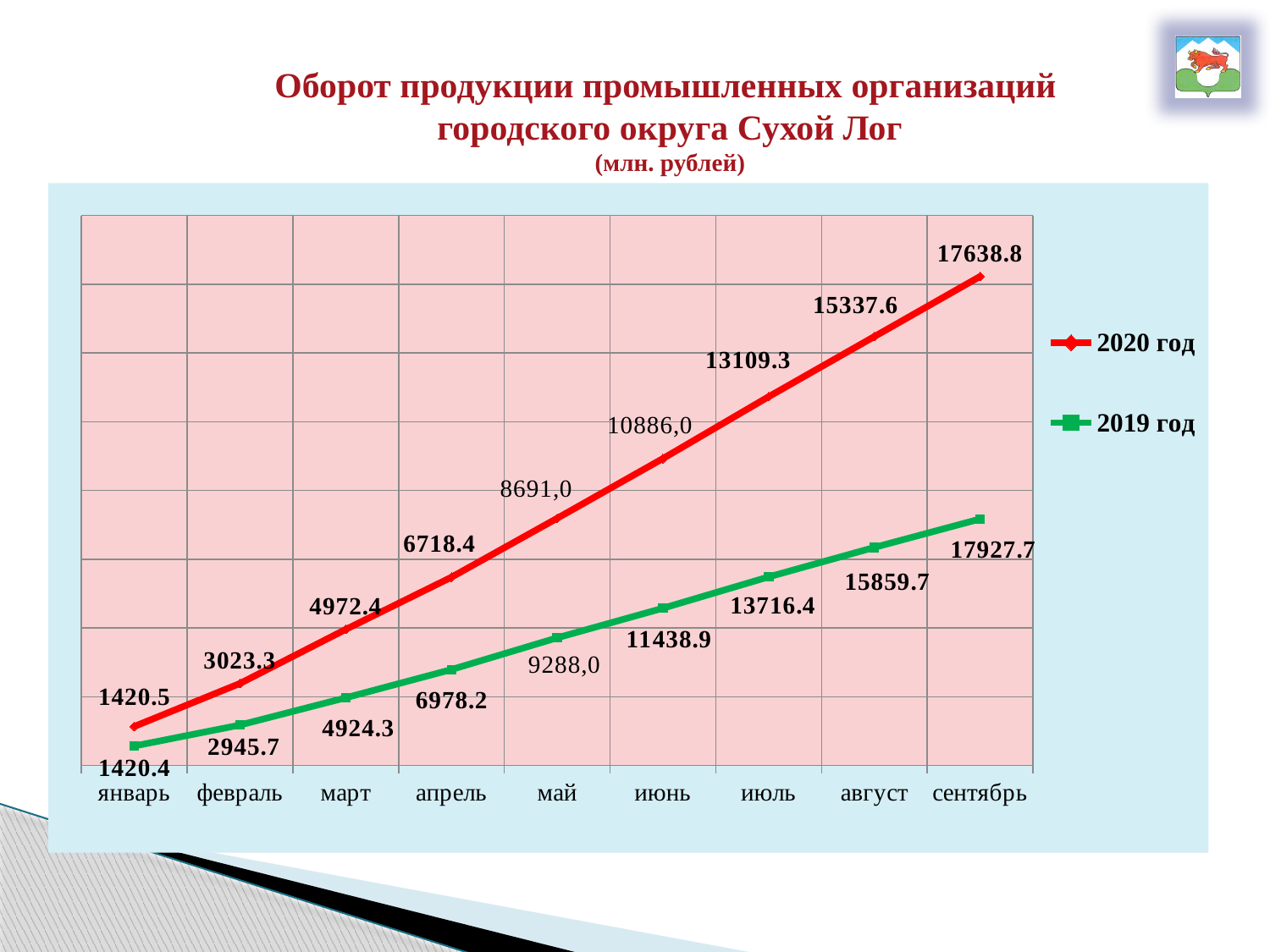
What unit is given in the chart title? млн. рублей How many series does the legend list? 2 In which month is the value for 2019 год the highest? сентябрь How many months are shown on the x axis? 9 What is the value for 2019 год in май? 9288,0 In which month is the value for 2020 год the lowest? январь What is the value for 2020 год in сентябрь? 17638.8 What type of chart is shown on the slide? line chart What is the value for 2020 год in апрель? 6718.4 What is the value for 2019 год in июль? 13716.4 Do the values for 2019 год rise or fall from январь to сентябрь? rise What is the difference between the 2020 год values for сентябрь and август? 2301.2